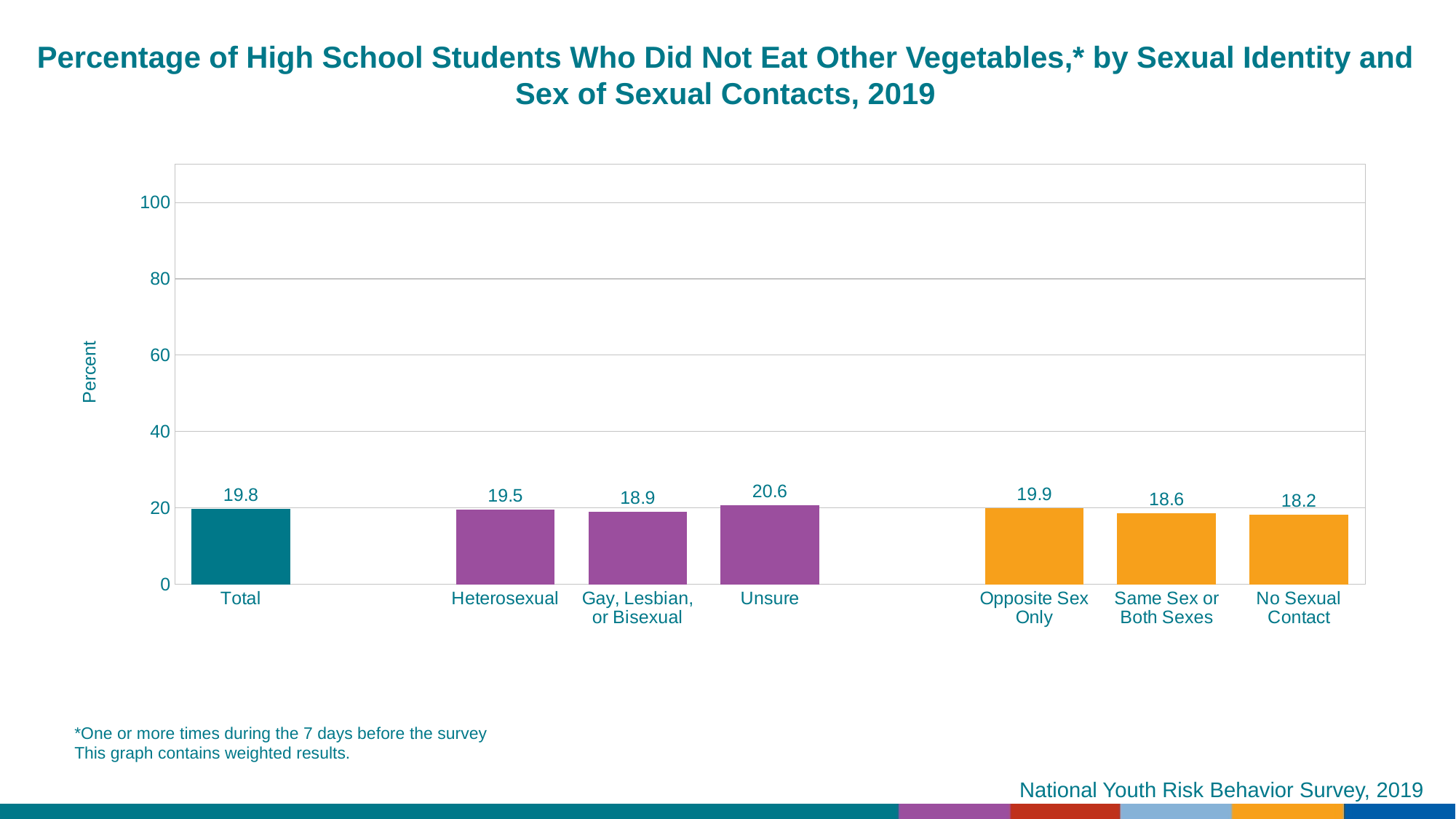
Which category has the highest value? Unsure What is the value for No Sexual Contact? 18.2 Is the value for Total greater or less than 40? less What is the difference between the values for Unsure and No Sexual Contact? 2.4 How many bars are shown in the chart? 7 What is the value for Total? 19.8 What is the value for Unsure? 20.6 Which category has the lowest value? No Sexual Contact What is the value for Same Sex or Both Sexes? 18.6 What kind of chart is shown on the slide? bar chart Which is larger, the value for Heterosexual or the value for Gay, Lesbian, or Bisexual? Heterosexual What is the difference between the values for Opposite Sex Only and Same Sex or Both Sexes? 1.3